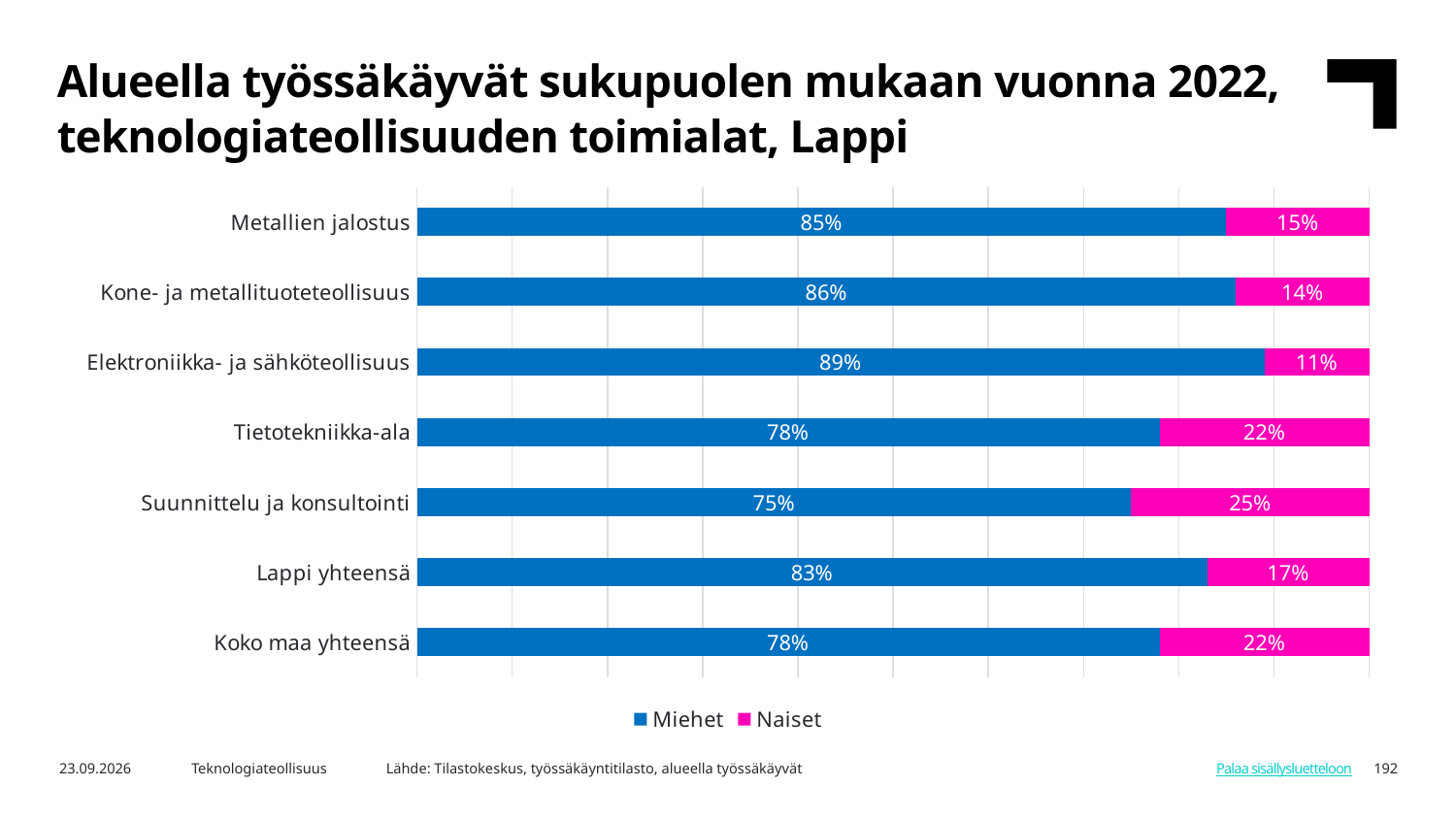
Which category has the highest Miehet share? Elektroniikka- ja sähköteollisuus What is the difference between the Naiset share for Tietotekniikka-ala and the Naiset share for Elektroniikka- ja sähköteollisuus? 11% How many categories are shown on the chart? 7 What is the Naiset share for Lappi yhteensä? 17% What kind of chart is shown on the slide? Stacked bar chart Which series is shown in pink? Naiset What is the total of the stacked bar for Koko maa yhteensä? 100% How many series does the legend list? 2 What is the Miehet share for Metallien jalostus? 85% Which category has the lowest Miehet share? Suunnittelu ja konsultointi What is the Naiset share for Suunnittelu ja konsultointi? 25% Which is larger: the Naiset share for Kone- ja metallituoteteollisuus or the Naiset share for Metallien jalostus? Metallien jalostus